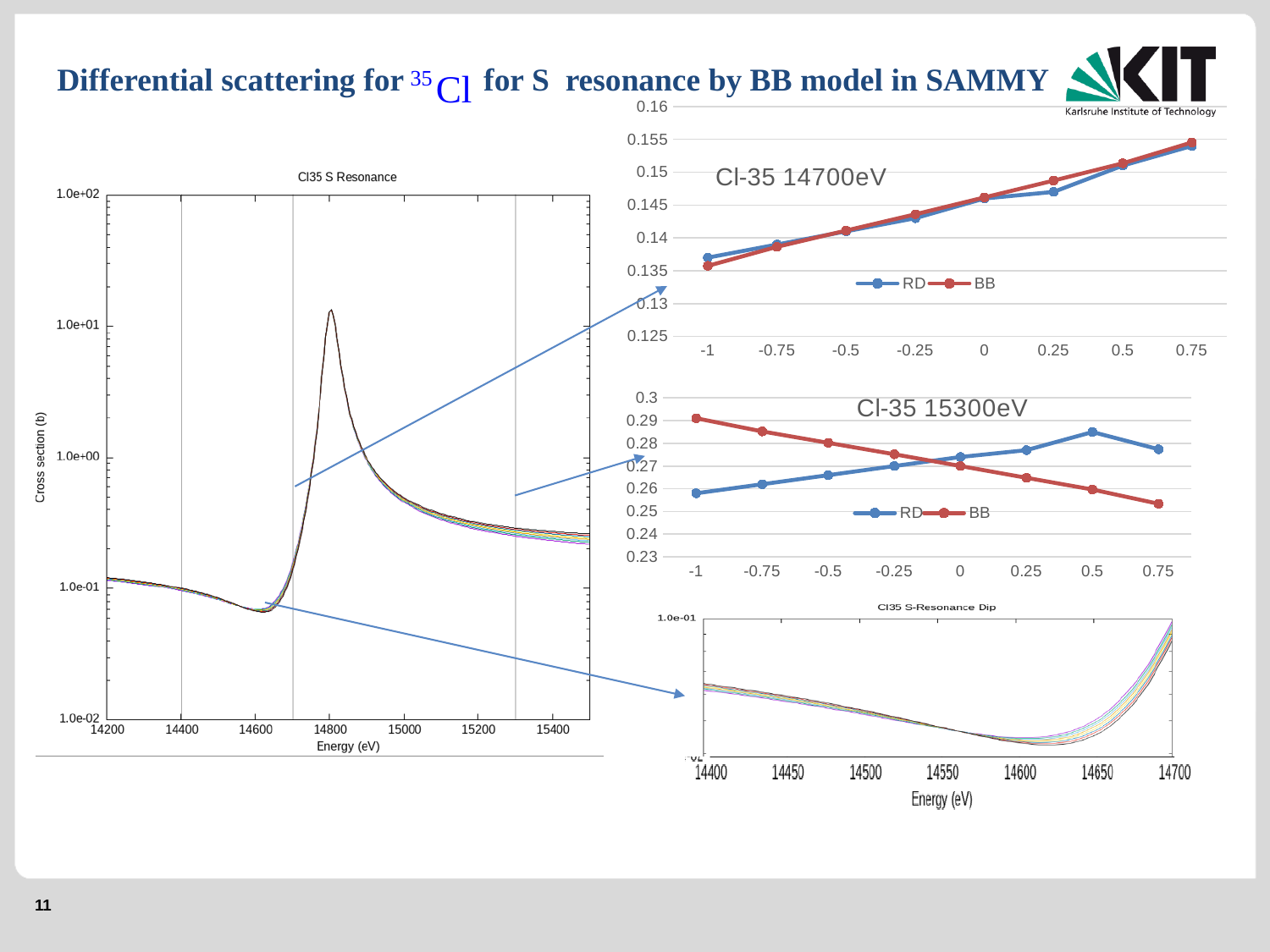
In the 'Cl-35 14700eV' chart, do the BB values rise or fall as x goes from -1 to 0.75? rise What type of chart is the 'Cl-35 14700eV' chart? line chart In the 'Cl-35 15300eV' chart, is the BB value at x = -1 greater or less than 0.28? greater In the 'Cl-35 14700eV' chart, how many x-axis points are plotted for each series? 8 In the 'Cl-35 15300eV' chart, at x = 0.75, which series has the larger value, RD or BB? RD What is the title of the chart at the bottom right of the slide? Cl35 S-Resonance Dip In the 'Cl-35 15300eV' chart, do the BB values rise or fall as x goes from -1 to 0.75? fall In the 'Cl-35 15300eV' chart, at x = -1, which series has the larger value, RD or BB? BB In the 'Cl-35 15300eV' chart, is the BB value at x = 0.75 greater or less than 0.26? less In the 'Cl-35 14700eV' chart, is the BB value at x = 0.75 greater or less than 0.15? greater How many series does the legend of the 'Cl-35 15300eV' chart list? 2 What is the x-axis label of the large 'Cl35 S Resonance' chart on the left? Energy (eV)